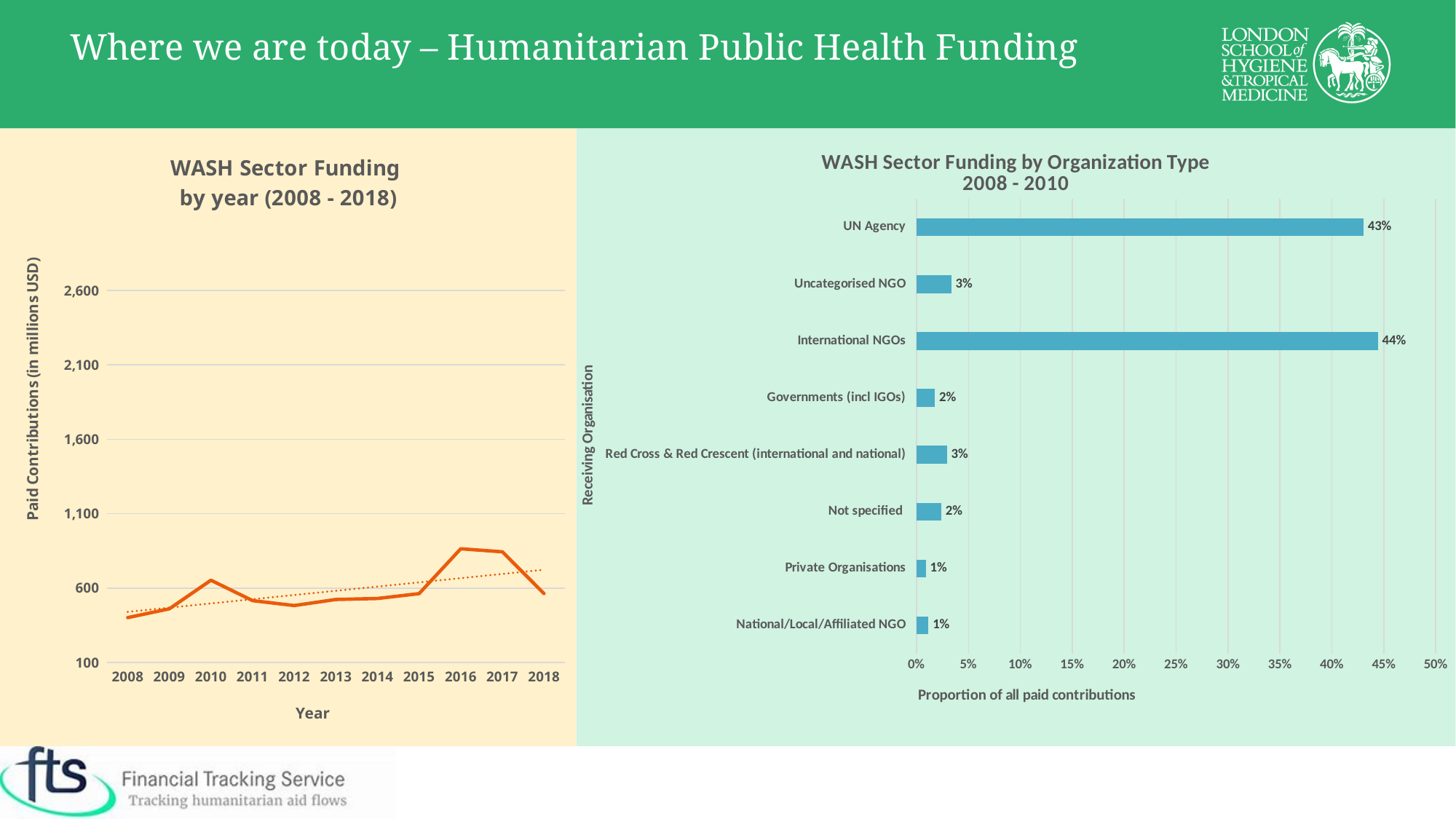
In the 'WASH Sector Funding by Organization Type 2008 - 2010' chart, what is the value for Red Cross & Red Crescent (international and national)? 3% In the 'WASH Sector Funding by Organization Type 2008 - 2010' chart, what proportion of all paid contributions went to UN Agency? 43% How many receiving organisation types are shown in the 'WASH Sector Funding by Organization Type 2008 - 2010' chart? 8 In the 'WASH Sector Funding by Organization Type 2008 - 2010' chart, what is the difference in percentage points between International NGOs and UN Agency? 1 percentage point In the 'WASH Sector Funding by Organization Type 2008 - 2010' chart, which is larger: Uncategorised NGO or Governments (incl IGOs)? Uncategorised NGO In the 'WASH Sector Funding by year (2008 - 2018)' chart, which year has the lowest paid contributions? 2008 In the 'WASH Sector Funding by Organization Type 2008 - 2010' chart, which receiving organisation type has the highest proportion? International NGOs What kind of chart is the 'WASH Sector Funding by Organization Type 2008 - 2010' chart? Bar chart How many years are plotted on the x axis of the 'WASH Sector Funding by year (2008 - 2018)' chart? 11 In the 'WASH Sector Funding by year (2008 - 2018)' chart, is the value for 2016 greater or less than 600? greater In the 'WASH Sector Funding by Organization Type 2008 - 2010' chart, what is the value for International NGOs? 44% In the 'WASH Sector Funding by year (2008 - 2018)' chart, is the value for 2008 greater or less than 600? less